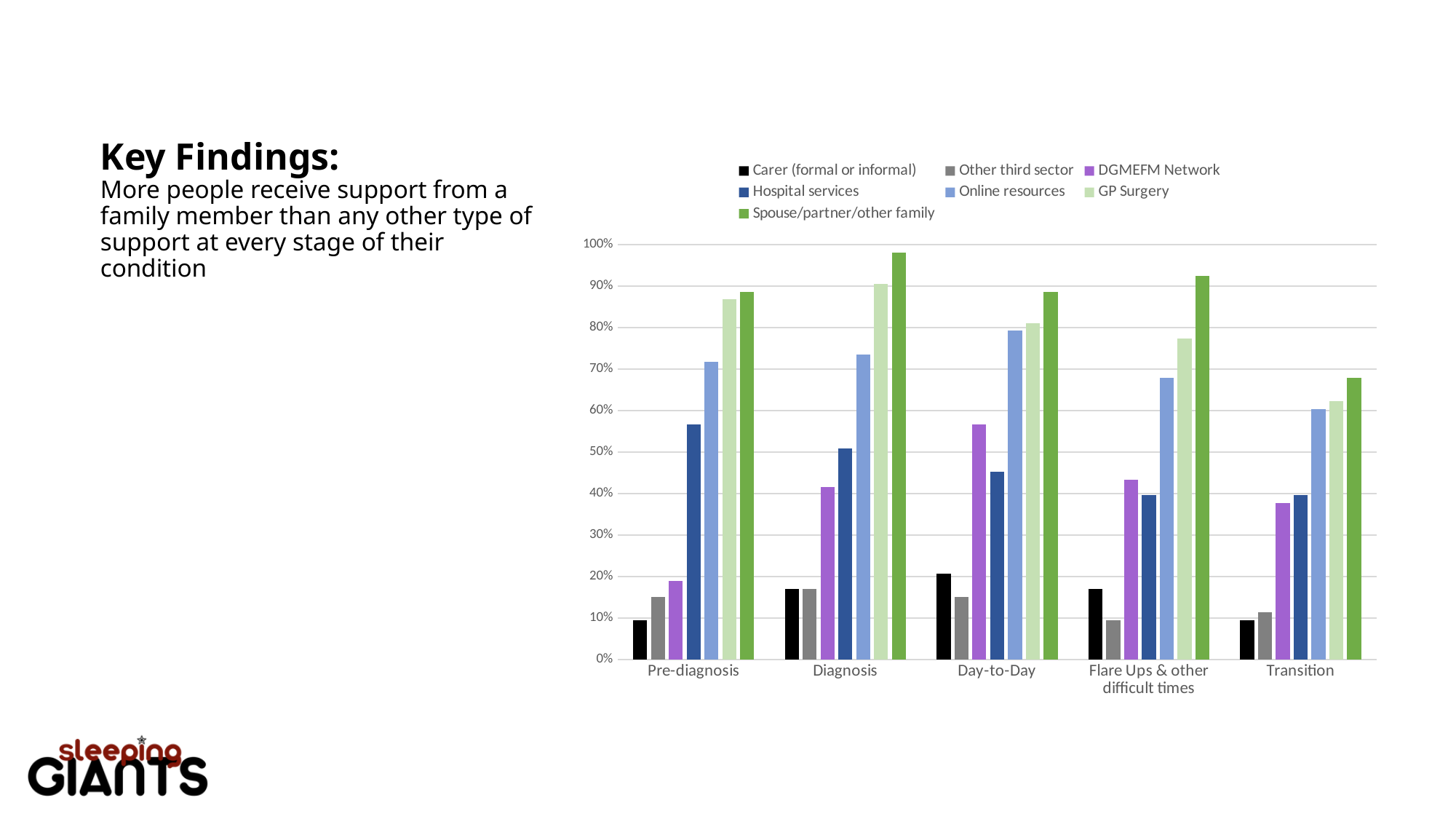
How many stage categories are shown along the x axis? 5 What kind of chart is shown on the slide? bar chart Is the value for Online resources at Transition greater or less than 70%? less At Flare Ups & other difficult times, which series has the lowest value? Other third sector Is the value for Hospital services at Pre-diagnosis greater or less than 50%? greater At which stage is the Spouse/partner/other family value lowest? Transition At which stage is the Spouse/partner/other family value highest? Diagnosis Which series is drawn in black? Carer (formal or informal) Is the value for GP Surgery at Diagnosis greater or less than 80%? greater At Day-to-Day, which is larger: Carer (formal or informal) or Other third sector? Carer (formal or informal) How many series does the legend list? 7